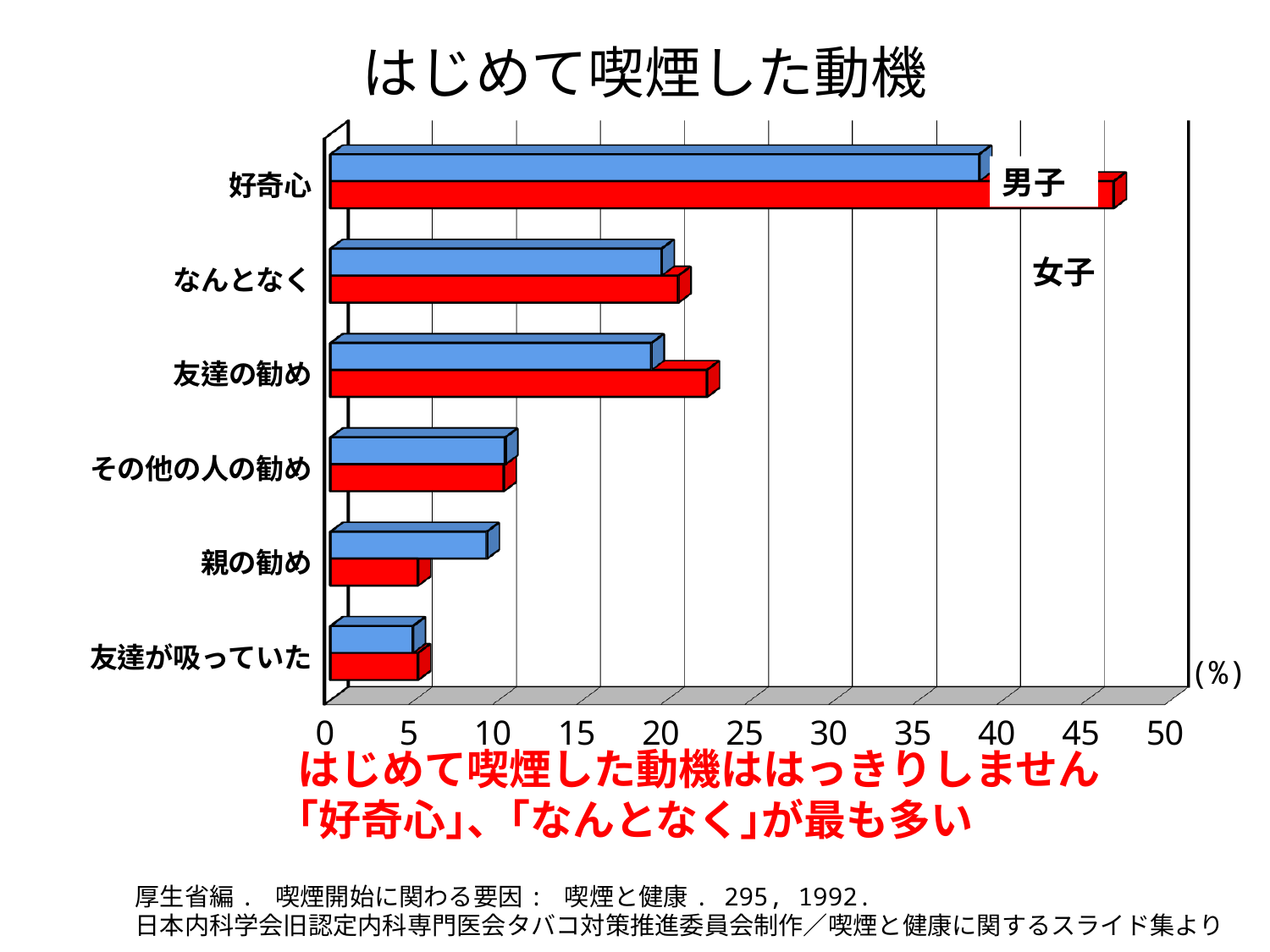
What kind of chart is shown on the slide? bar chart Which motive has the highest value for 男子? 好奇心 For 好奇心, which is larger, the value for 男子 or for 女子? 女子 Is the value for 女子 in 好奇心 greater or less than 40? greater Which motive has the highest value for 女子? 好奇心 For 親の勧め, which is larger, the value for 男子 or for 女子? 男子 Is the value for 男子 in 親の勧め greater or less than 5? greater What colour are the bars for 男子? blue Which motive has the lowest value for 男子? 友達が吸っていた How many series does the chart show? 2 How many categories (motives) are listed on the chart? 6 Is the value for 女子 in 親の勧め greater or less than 10? less